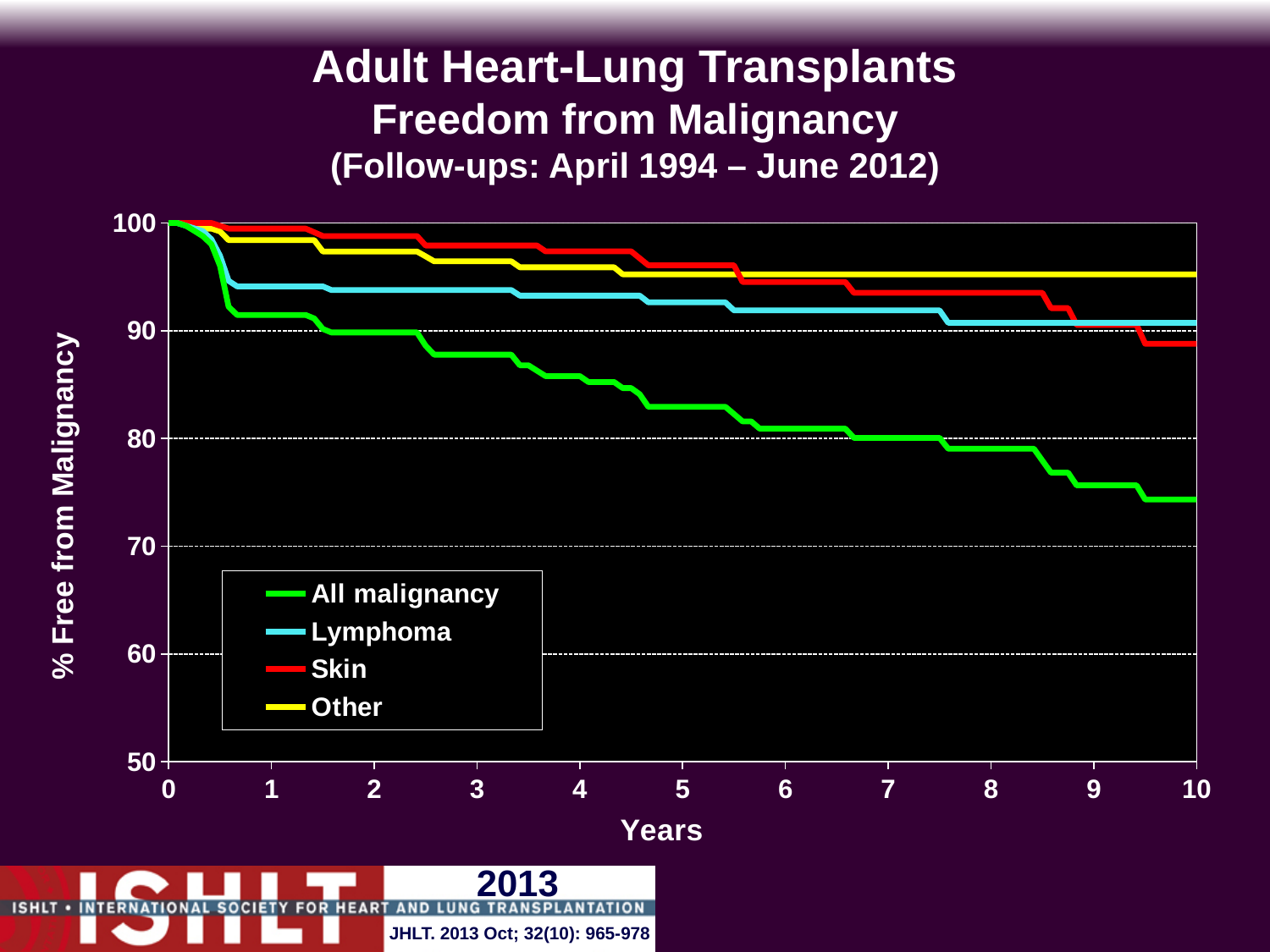
What colour is the Skin line in the legend? red Which series is highest at 10 years? Other How many series does the legend list? 4 At 10 years, which is larger, the value for Other or the value for All malignancy? Other Is the value for All malignancy at 10 years greater or less than 80? less Is the value for Lymphoma at 5 years greater or less than 90? greater What is the label of the y axis? % Free from Malignancy What kind of chart is shown on the slide? line chart Is the value for All malignancy at 5 years greater or less than 80? greater Do the values for All malignancy rise or fall as years increase? fall Which series is lowest at 10 years? All malignancy